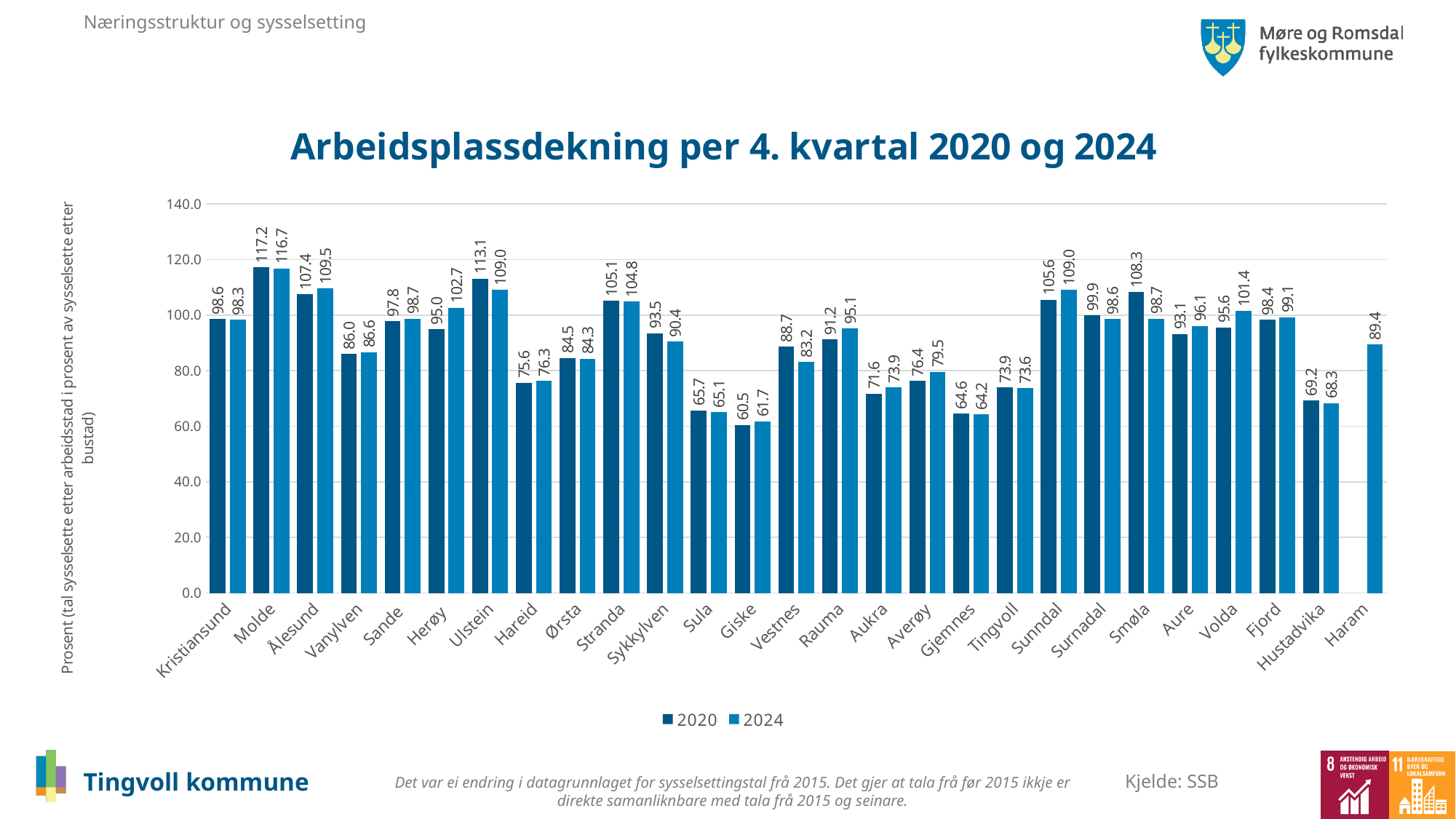
Which municipality has the highest 2020 value? Molde What is the title of the chart? Arbeidsplassdekning per 4. kvartal 2020 og 2024 Which is larger for Ulstein, the 2020 value or the 2024 value? 2020 Which municipality has the lowest 2024 value? Giske How many series does the legend list? 2 How many municipalities are shown on the x axis? 27 What is the difference between the 2020 and 2024 values for Smøla? 9.6 What is the 2024 value for Herøy? 102.7 Is the 2024 value for Sunndal greater or less than 100.0? greater What is the 2020 value for Tingvoll? 73.9 What is the 2024 value for Haram? 89.4 What kind of chart is shown? Bar chart